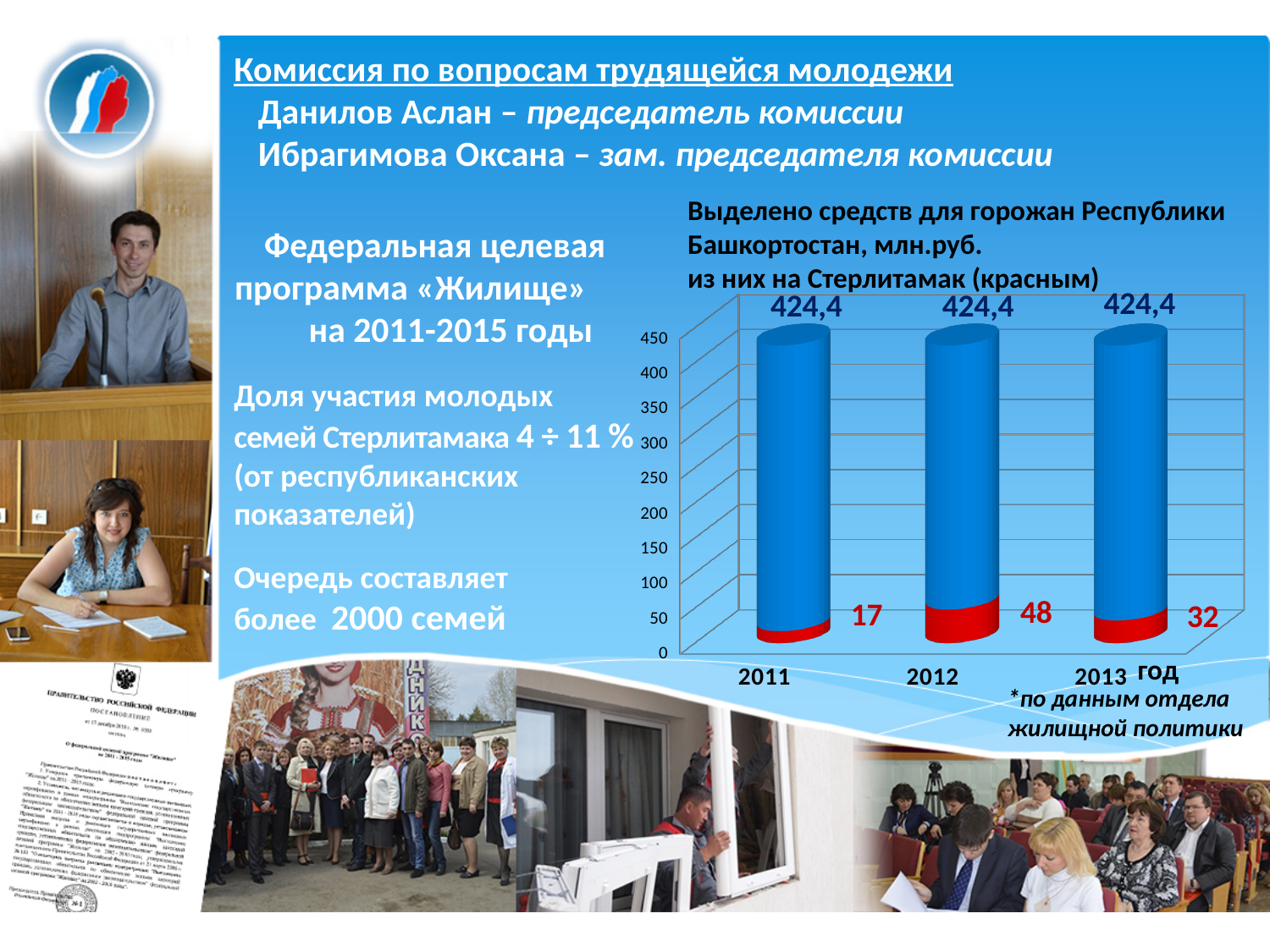
In which year is the red Sterlitamak value the highest? 2012 Do the blue values for the Republic of Bashkortostan rise, fall or stay the same from 2011 to 2013? stay the same What is the difference between the red Sterlitamak values for 2012 and 2013? 16 Which year has the larger red Sterlitamak value, 2011 or 2013? 2013 What is the difference between the red Sterlitamak values for 2012 and 2011? 31 How many years are shown on the x axis of the chart? 3 What value is shown for the Republic of Bashkortostan (blue) in 2011? 424,4 What value is shown in red for Sterlitamak in 2013? 32 What value is shown in red for Sterlitamak in 2011? 17 What kind of chart is shown on the slide? bar chart In which year is the red Sterlitamak value the lowest? 2011 What value is shown in red for Sterlitamak in 2012? 48